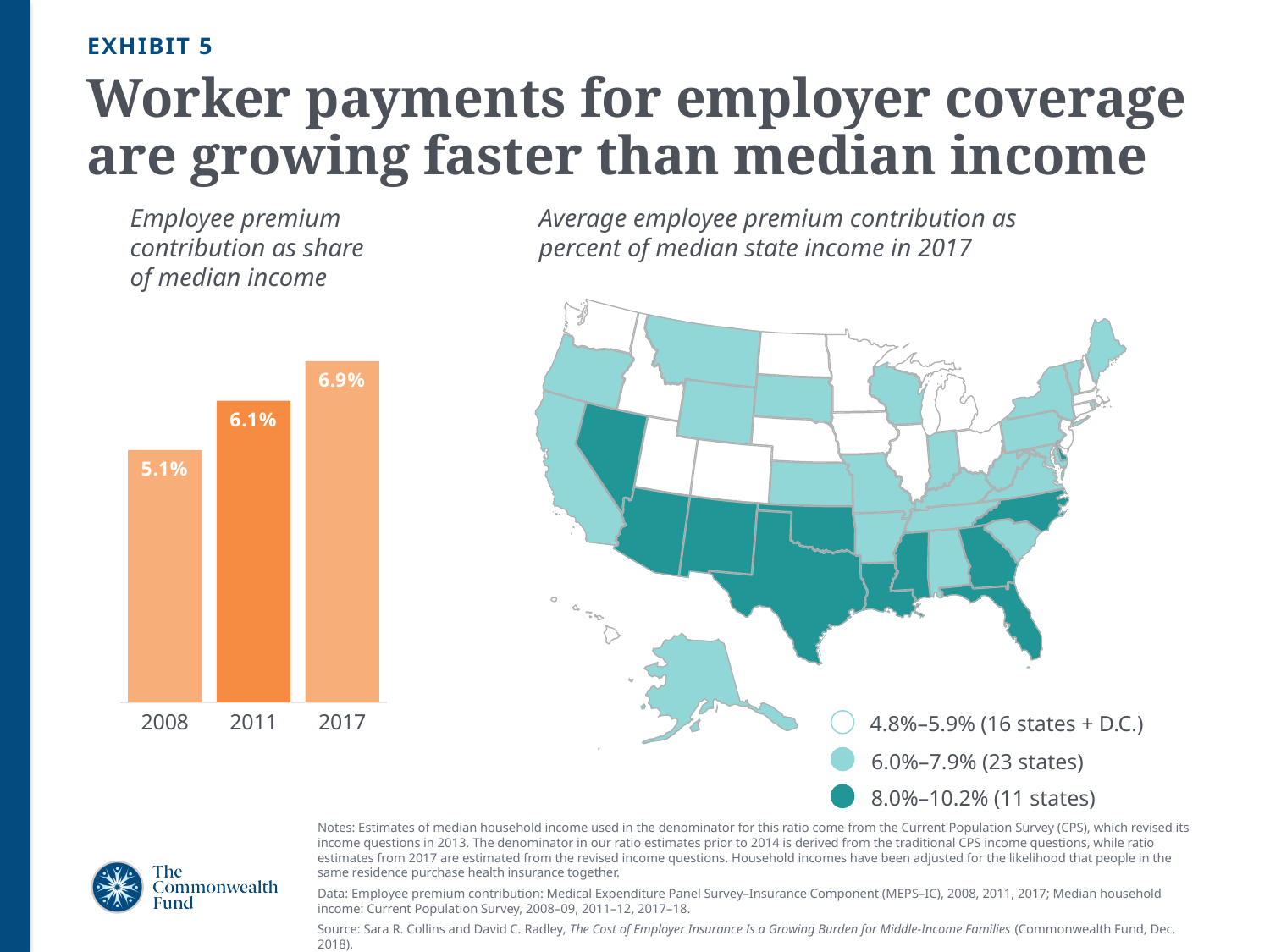
In the bar chart 'Employee premium contribution as share of median income', what is the value for 2008? 5.1% In the bar chart 'Employee premium contribution as share of median income', what is the value for 2017? 6.9% In the bar chart 'Employee premium contribution as share of median income', which year has the lowest value? 2008 In the bar chart 'Employee premium contribution as share of median income', by how many percentage points did the value increase from 2008 to 2017? 1.8 percentage points In the bar chart 'Employee premium contribution as share of median income', which is larger, the value for 2011 or the value for 2017? 2017 How many years are shown in the bar chart 'Employee premium contribution as share of median income'? 3 In the bar chart 'Employee premium contribution as share of median income', which year has the highest value? 2017 In the bar chart 'Employee premium contribution as share of median income', do the values rise or fall from 2008 to 2017? Rise What kind of chart is used to show 'Employee premium contribution as share of median income'? Bar chart In the bar chart 'Employee premium contribution as share of median income', what is the difference between the 2011 and 2008 values? 1.0 percentage point In the bar chart 'Employee premium contribution as share of median income', what is the value for 2011? 6.1% In the map 'Average employee premium contribution as percent of median state income in 2017', how many states fall in the 8.0%–10.2% category according to the legend? 11 states